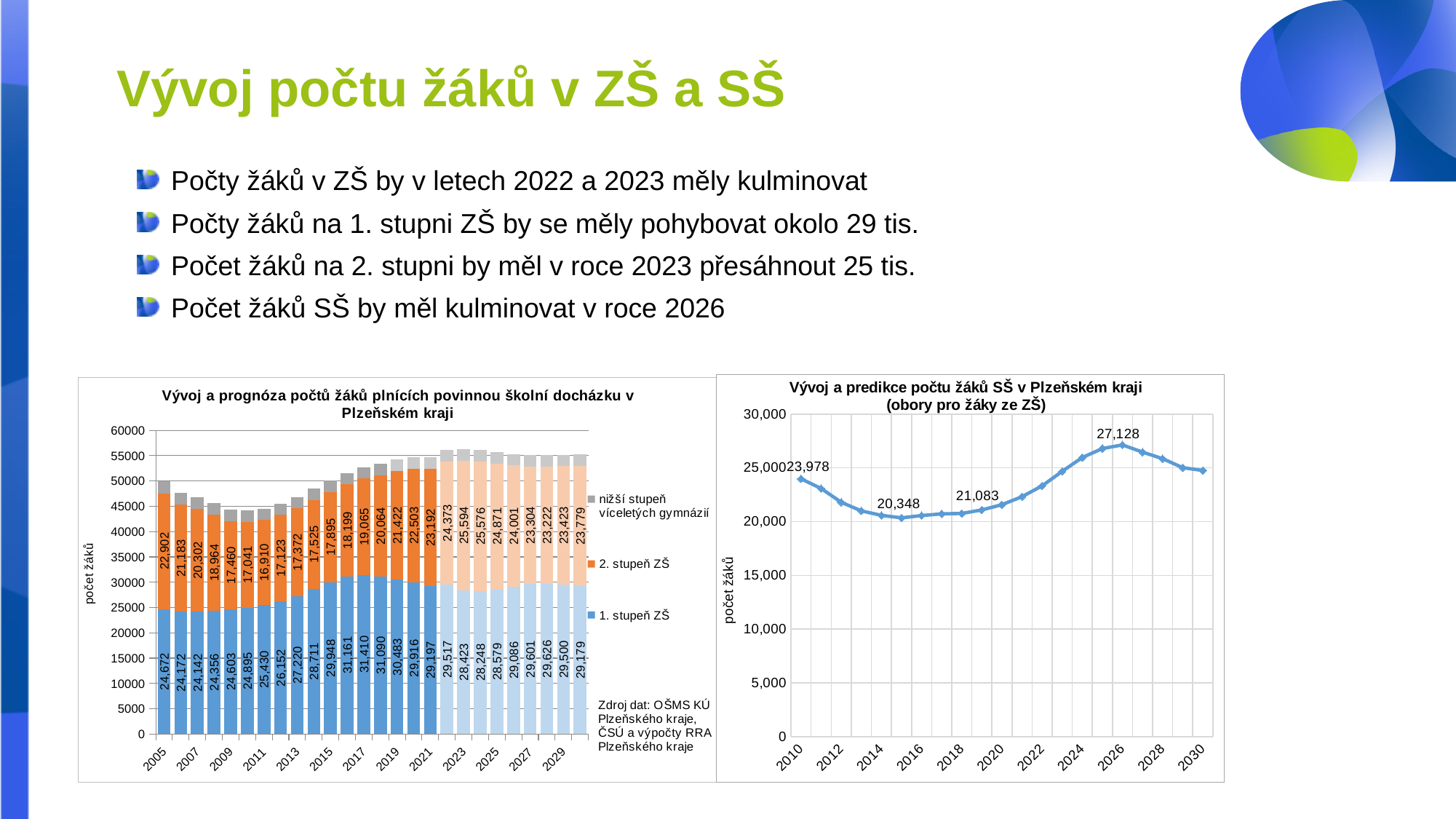
What kind of chart is the right chart, 'Vývoj a predikce počtu žáků SŠ v Plzeňském kraji'? Line chart In the left chart, in which year is the '2. stupeň ZŠ' value lowest? 2011 In the left chart, what is the difference between the '2. stupeň ZŠ' values for 2005 and 2011? 5,992 In the left chart, in which year is the '1. stupeň ZŠ' value highest? 2017 What kind of chart is the left chart, 'Vývoj a prognóza počtů žáků plnících povinnou školní docházku v Plzeňském kraji'? Stacked bar chart In the left chart, what is the value for '2. stupeň ZŠ' in 2023? 25,594 In the right chart, is the value for 2020 greater or less than 25,000? less In the left chart, what is the value for '1. stupeň ZŠ' in 2017? 31,410 In the right chart, what is the difference between the values for 2026 and 2015? 6,780 In the left chart, which is larger: the '1. stupeň ZŠ' value for 2016 or for 2017? 2017 In the left chart, how many series does the legend list? 3 In the right chart, what is the value for 2026? 27,128